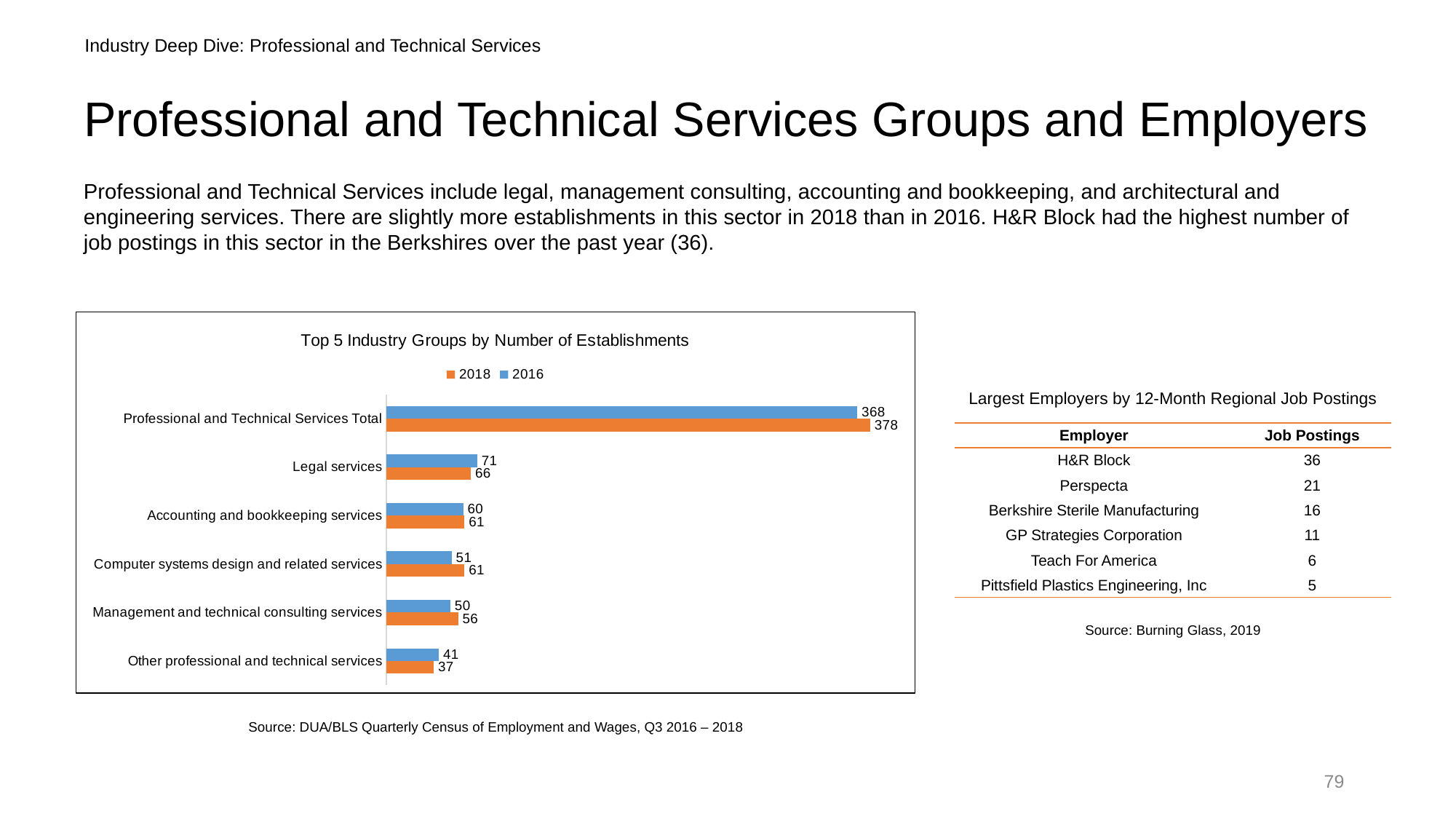
What is the 2016 value for Computer systems design and related services? 51 What is the difference between the 2018 and 2016 values for Management and technical consulting services? 6 What is the title of the chart? Top 5 Industry Groups by Number of Establishments Which category has the lowest 2018 value? Other professional and technical services What is the 2018 value for Legal services? 66 How many series does the chart legend list? 2 What type of chart is shown on the slide? Bar chart Excluding the Total category, which industry group has the highest 2016 value? Legal services How many categories are plotted in the chart? 6 What is the difference between the 2018 and 2016 values for Professional and Technical Services Total? 10 Which is larger for Other professional and technical services, the 2016 value or the 2018 value? 2016 What is the 2018 value for Professional and Technical Services Total? 378